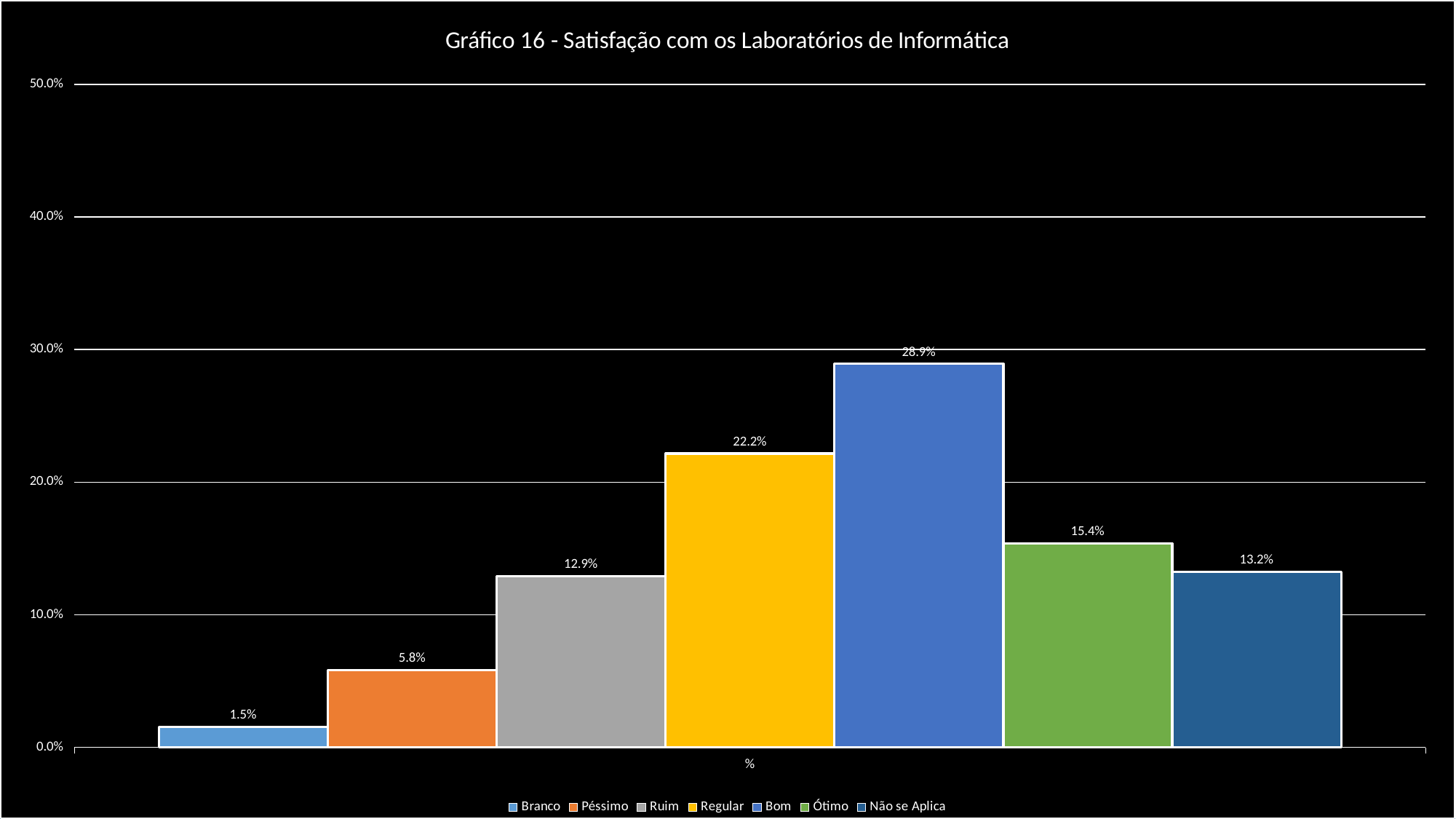
Is the value for Ótimo greater or less than 20.0%? less What is the value for Regular? 22.2% What is the value for Não se Aplica? 13.2% Which is larger, the value for Ruim or the value for Péssimo? Ruim What is the difference between the values for Ótimo and Não se Aplica? 2.2% What is the difference between the values for Bom and Regular? 6.7% What kind of chart is shown? bar chart Which category has the lowest value? Branco Which category has the highest value? Bom What is the value for Branco? 1.5% What is the value for Bom? 28.9% How many series does the legend list? 7